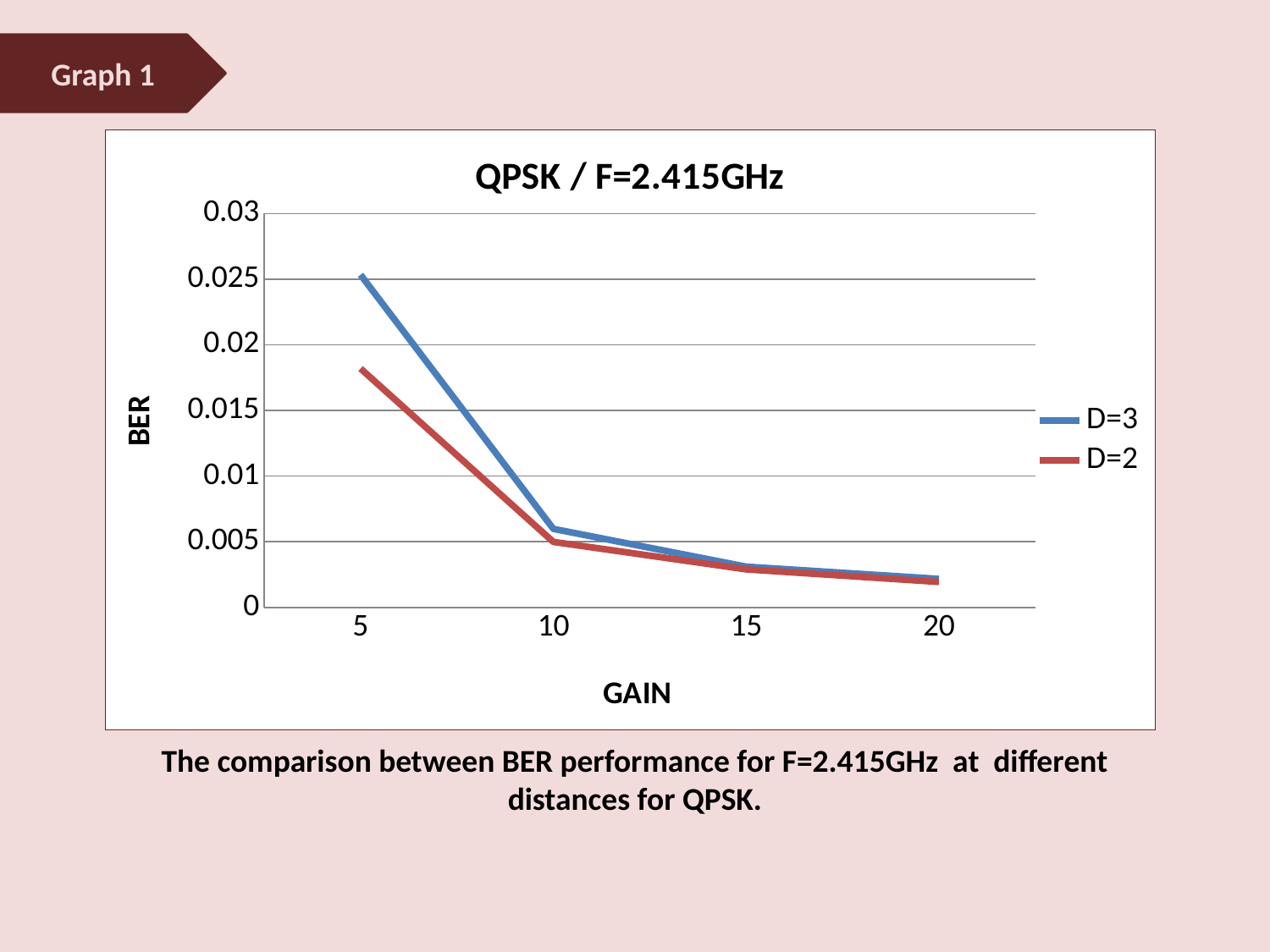
At which GAIN value is the BER for D=2 highest? 5 Does the BER for D=3 rise or fall as GAIN increases from 5 to 20? fall Is the BER for D=2 at GAIN 20 greater or less than 0.005? less Is the BER for D=2 at GAIN 5 greater or less than 0.02? less At GAIN 5, which series has the higher BER, D=3 or D=2? D=3 Is the BER for D=3 at GAIN 10 greater or less than 0.01? less What is the title of the chart? QPSK / F=2.415GHz What kind of chart is shown on the slide? line chart How many GAIN values are plotted along the x axis? 4 What is the label of the y axis? BER How many series does the legend list? 2